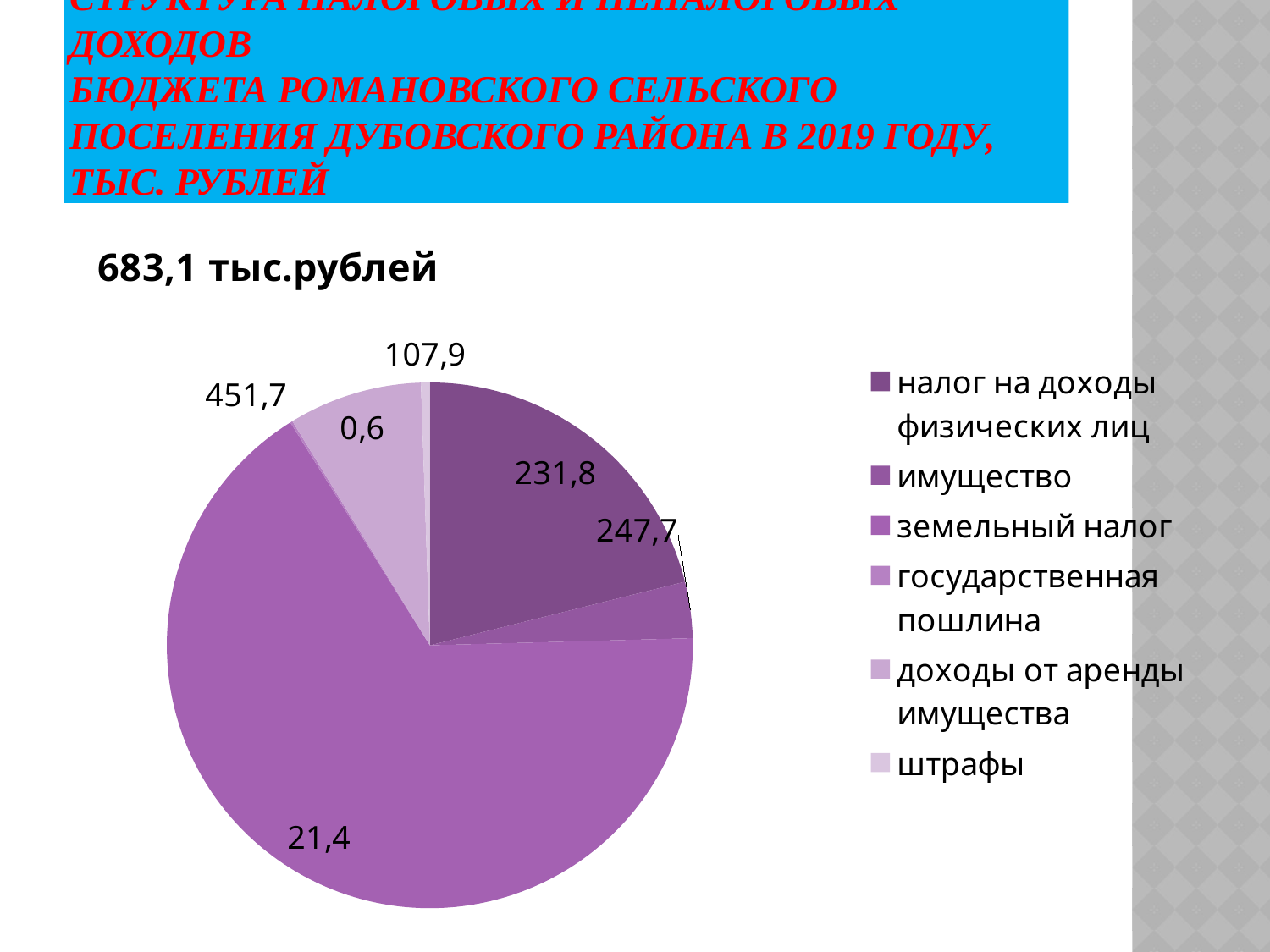
What kind of chart is shown on the slide? pie chart Which category is listed last in the legend of the pie chart? штрафы What value is labelled inside the slice for доходы от аренды имущества? 0,6 Which year does the chart title say the budget structure refers to? 2019 Which category has the largest slice in the pie chart? земельный налог Which slice is larger in the pie chart: земельный налог or налог на доходы физических лиц? земельный налог What value is labelled on the slice for налог на доходы физических лиц? 231,8 What total amount in тыс.рублей is printed above the pie chart? 683,1 тыс.рублей How many categories does the legend of the pie chart list? 6 What value is labelled inside the slice for земельный налог? 21,4